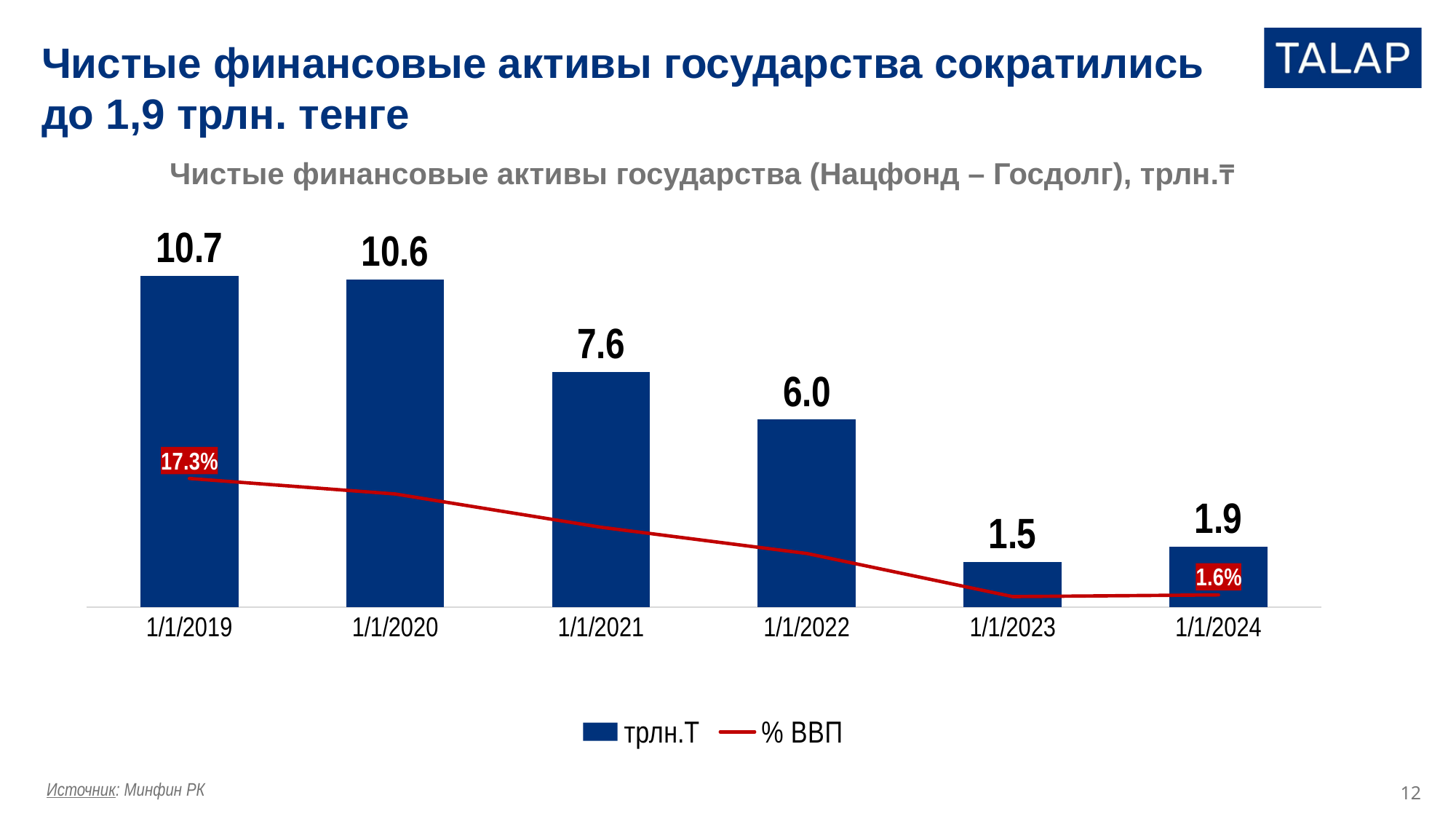
What is the % ВВП value shown for 1/1/2024? 1.6% How many series does the legend list? 2 Which is larger, the трлн.Т value for 1/1/2023 or for 1/1/2024? 1/1/2024 How many dates are shown on the x axis? 6 Do the трлн.Т bar values generally rise or fall from 1/1/2019 to 1/1/2023? fall What is the value of the трлн.Т bar for 1/1/2022? 6.0 Which date has the lowest трлн.Т bar? 1/1/2023 What is the % ВВП value shown for 1/1/2019? 17.3% What is the value of the трлн.Т bar for 1/1/2019? 10.7 What is the value of the трлн.Т bar for 1/1/2024? 1.9 Which date has the highest трлн.Т bar? 1/1/2019 What is the difference between the трлн.Т values for 1/1/2021 and 1/1/2022? 1.6